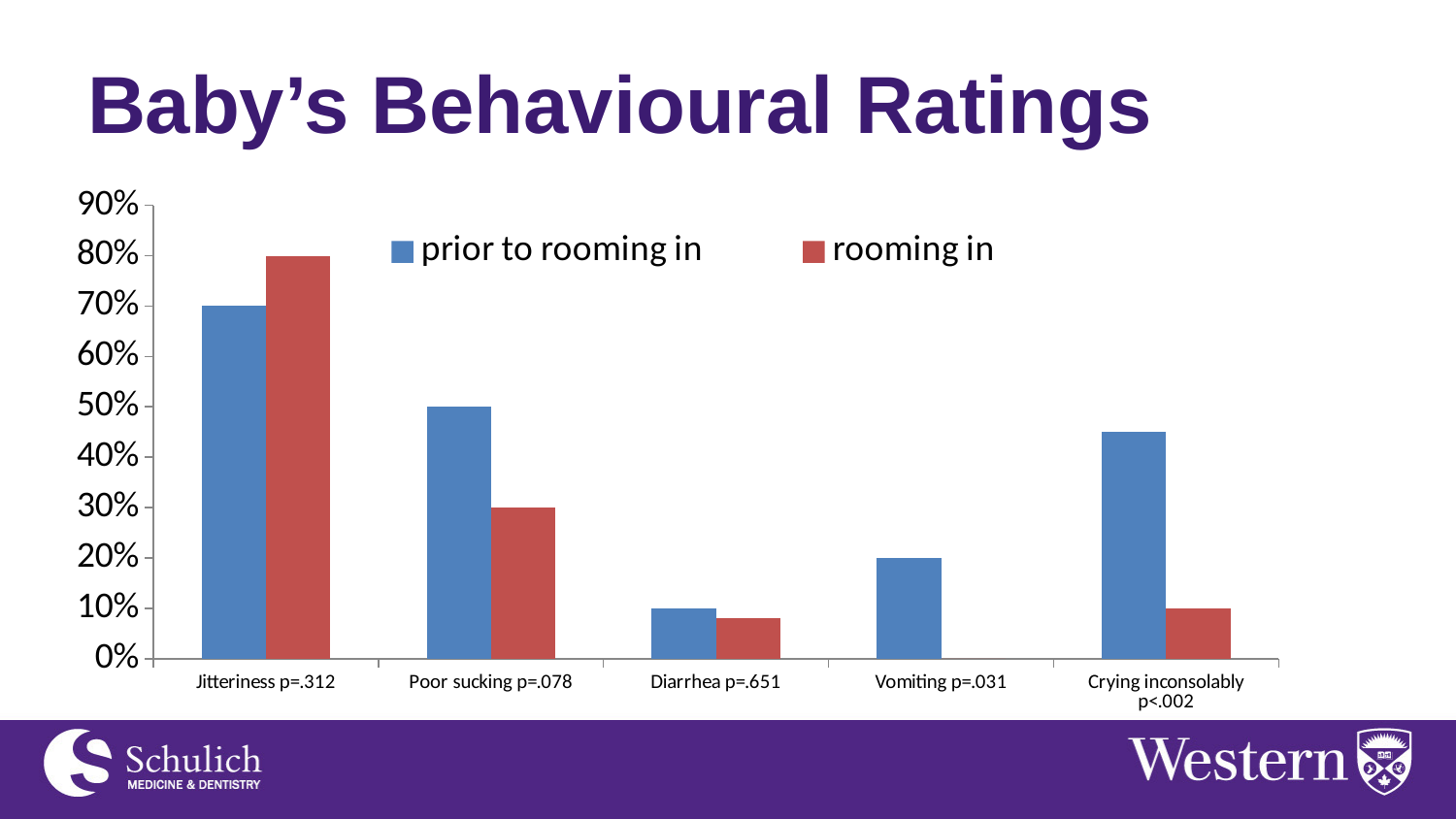
Which is larger for Jitteriness: the 'prior to rooming in' value or the 'rooming in' value? rooming in What is the value for 'rooming in' for Poor sucking? 30% What is the value for 'prior to rooming in' for Poor sucking? 50% What is the value for 'prior to rooming in' for Jitteriness? 70% Is the 'prior to rooming in' value for Crying inconsolably greater or less than 40%? greater How many behaviour categories are shown on the x axis? 5 What kind of chart is shown on the slide? bar chart What is the difference between the 'prior to rooming in' and 'rooming in' values for Poor sucking? 20% How many series does the legend list? 2 What colour represents the 'rooming in' series? red Which category has the highest 'rooming in' value? Jitteriness p=.312 What is the value for 'rooming in' for Jitteriness? 80%